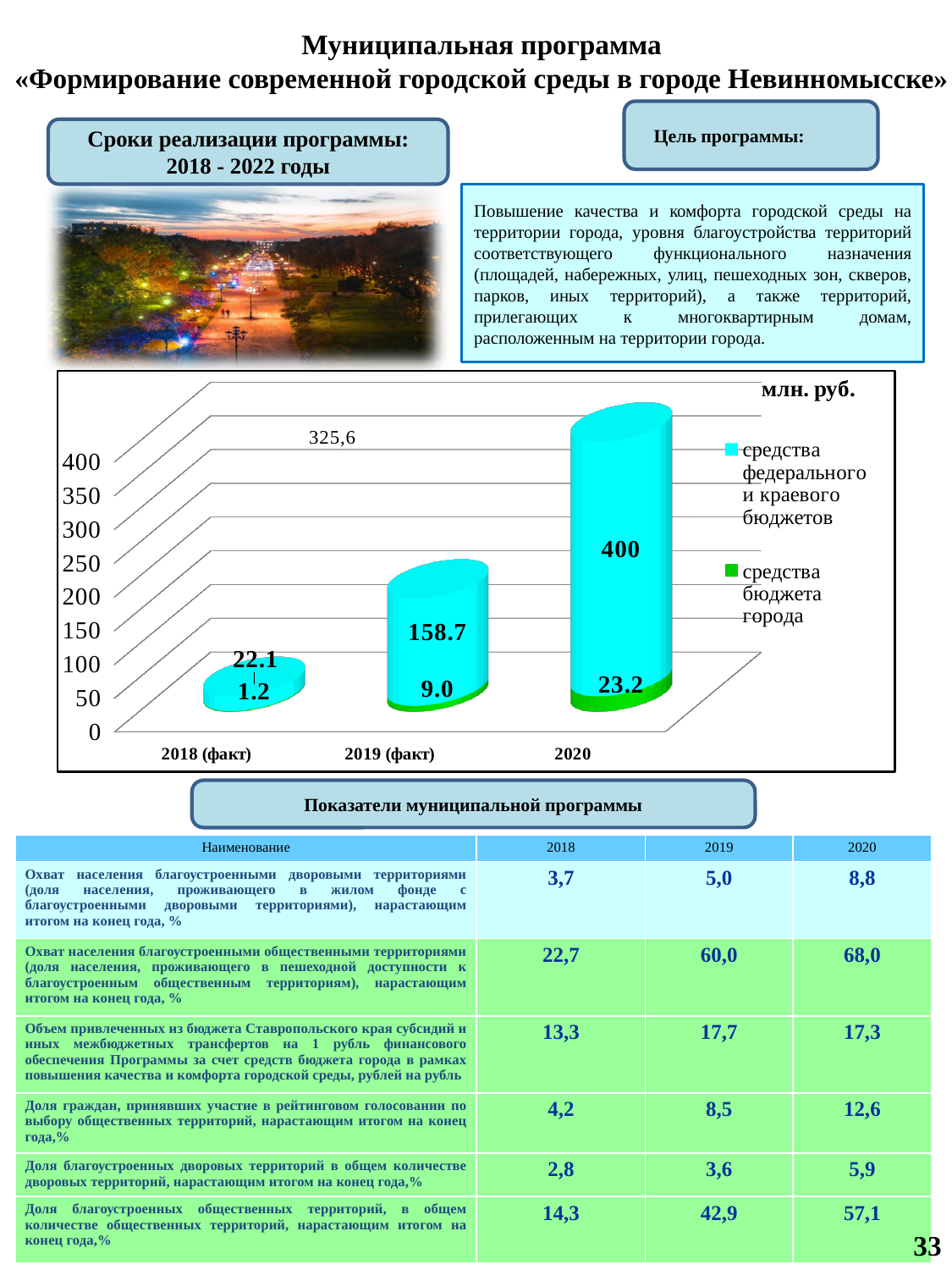
What is the difference between средства федерального и краевого бюджетов in 2020 and in 2019 (факт)? 241.3 Which year has the lowest value of средства бюджета города? 2018 (факт) What is the value of средства бюджета города for 2019 (факт)? 9.0 How many years (categories) are shown on the x axis of the chart? 3 Which year has the highest value of средства федерального и краевого бюджетов? 2020 What is the total of the stacked bar for 2019 (факт)? 167.7 What kind of chart is shown on the slide? bar chart What is the value of средства бюджета города for 2020? 23.2 What is the value of средства федерального и краевого бюджетов for 2020? 400 What is the value of средства федерального и краевого бюджетов for 2018 (факт)? 22.1 Which is larger: средства бюджета города in 2019 (факт) or in 2020? 2020 How many series does the chart legend list? 2